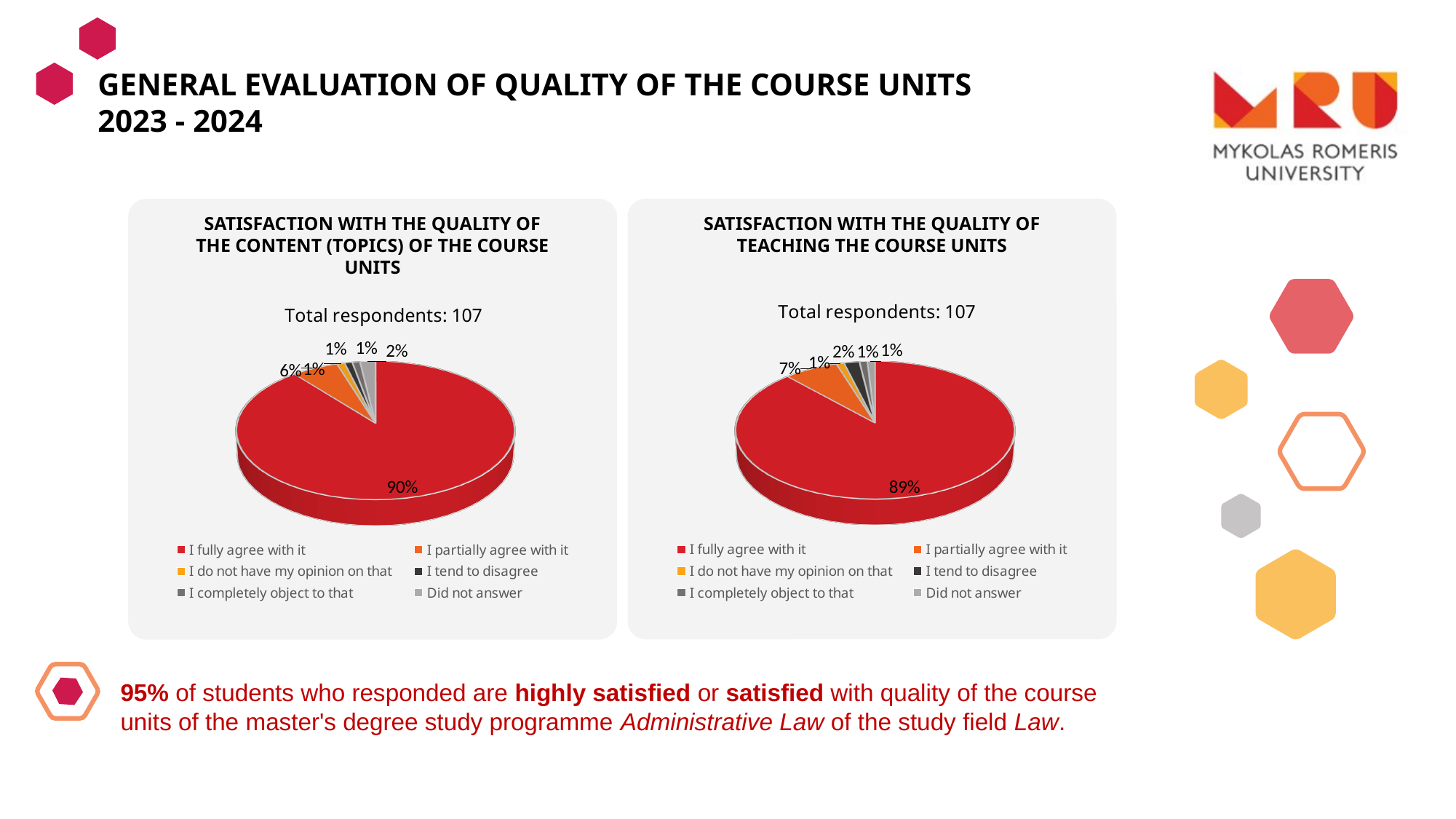
Which chart shows a larger share for 'I fully agree with it': the content chart or the teaching chart? The content chart In the left chart (content of the course units), is the share for 'I partially agree with it' greater or less than 10%? less In the left chart (content of the course units), which response category has the largest slice? I fully agree with it What type of chart is used in the 'Satisfaction with the quality of teaching the course units' panel? Pie chart What is the difference between the 'I fully agree with it' shares in the content chart and the teaching chart? 1% In the right chart (teaching the course units), what share of respondents chose 'I partially agree with it'? 7% In the right chart (teaching the course units), which response category has the largest slice? I fully agree with it How many total respondents are reported for the chart on the quality of teaching the course units? 107 In the left chart (content of the course units), what share of respondents chose 'I partially agree with it'? 6% How many response categories does the legend of the left chart (content of the course units) list? 6 In the chart titled 'Satisfaction with the quality of teaching the course units', what share of respondents chose 'I fully agree with it'? 89% In the chart titled 'Satisfaction with the quality of the content (topics) of the course units', what share of respondents chose 'I fully agree with it'? 90%